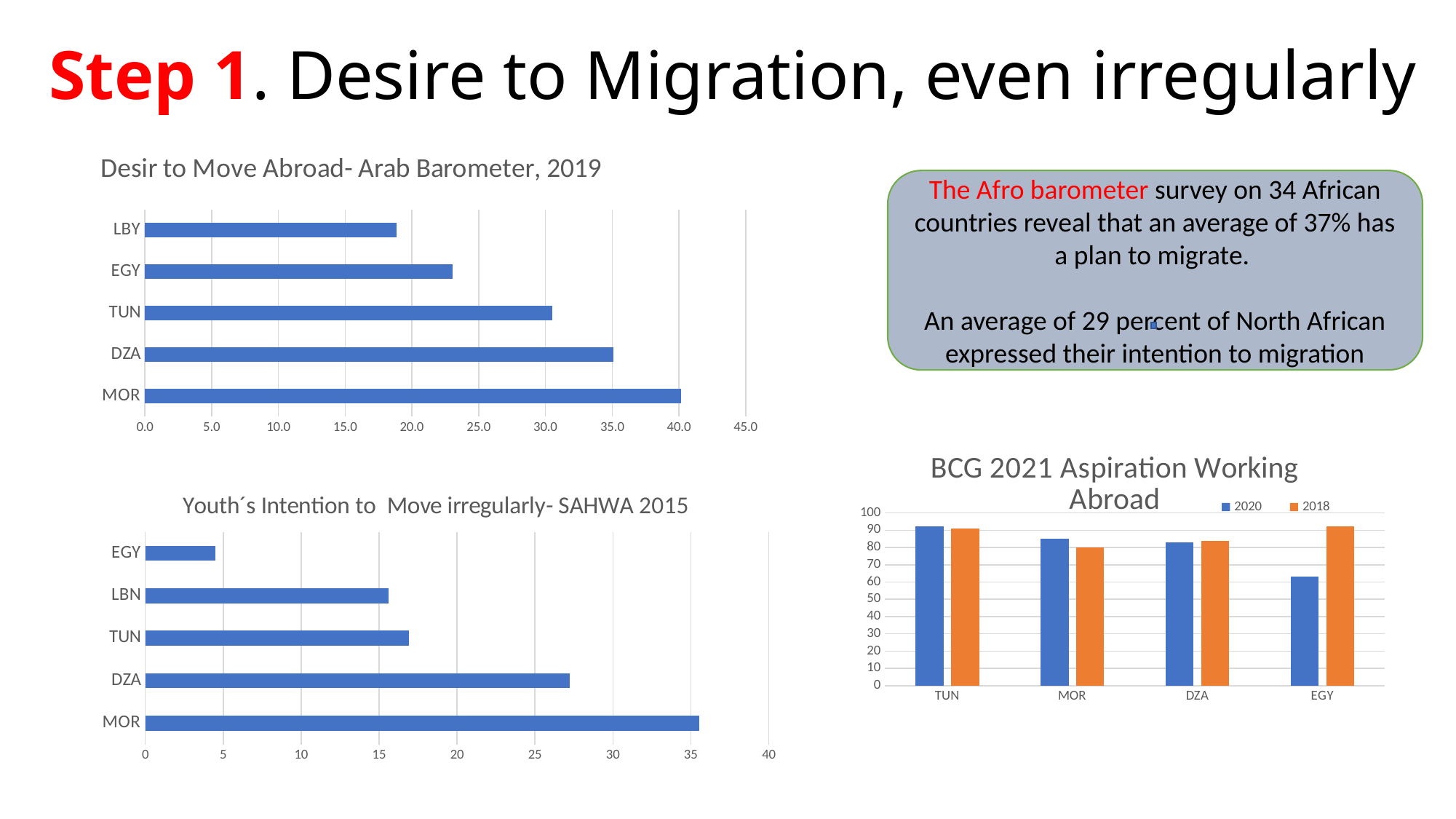
What kind of chart is the 'Youth's Intention to Move irregularly- SAHWA 2015' chart? bar chart In the 'Youth's Intention to Move irregularly- SAHWA 2015' chart, which country has the highest value? MOR In the 'Desir to Move Abroad- Arab Barometer, 2019' chart, which country has the lowest value? LBY How many series does the legend of the 'BCG 2021 Aspiration Working Abroad' chart list? 2 In the 'Desir to Move Abroad- Arab Barometer, 2019' chart, is the value for LBY greater or less than 20.0? less In the 'Desir to Move Abroad- Arab Barometer, 2019' chart, which country has the highest value? MOR How many countries are shown in the 'Desir to Move Abroad- Arab Barometer, 2019' chart? 5 In the 'BCG 2021 Aspiration Working Abroad' chart, which is larger for EGY, the 2020 value or the 2018 value? 2018 In the 'Youth's Intention to Move irregularly- SAHWA 2015' chart, which country has the lowest value? EGY In the 'Desir to Move Abroad- Arab Barometer, 2019' chart, is the value for MOR greater or less than 35.0? greater In the 'BCG 2021 Aspiration Working Abroad' chart, is the 2020 value for EGY greater or less than 70? less